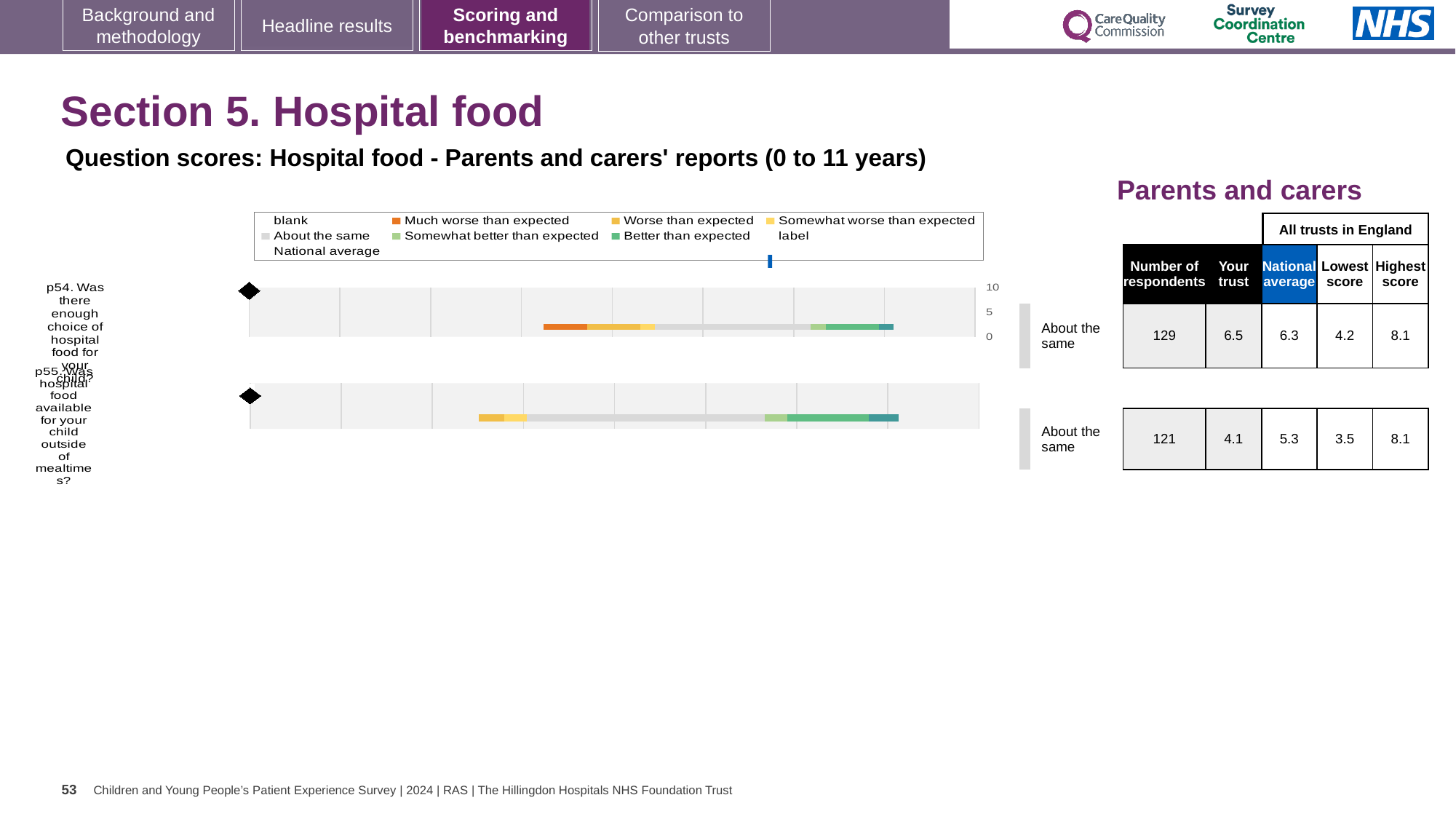
How many respondents answered p54? 129 What is the lowest score among all trusts in England for p54? 4.2 What kind of chart is used to show the question scores for hospital food? Bar chart What is the 'Your trust' score for p54 (Was there enough choice of hospital food for your child?)? 6.5 What is the difference between the highest score and the lowest score for p55? 4.6 What is the national average score for p55 (Was hospital food available for your child outside of mealtimes?)? 5.3 By how much does the 'Your trust' score for p54 exceed the national average for p54? 0.2 Which question has the higher 'Your trust' score, p54 or p55? p54 What is the maximum value shown on the chart's score axis? 10 How many questions (categories) are plotted in the hospital food chart? 2 What benchmark category is shown for p55? About the same What colour represents 'Much worse than expected' in the chart legend? Orange